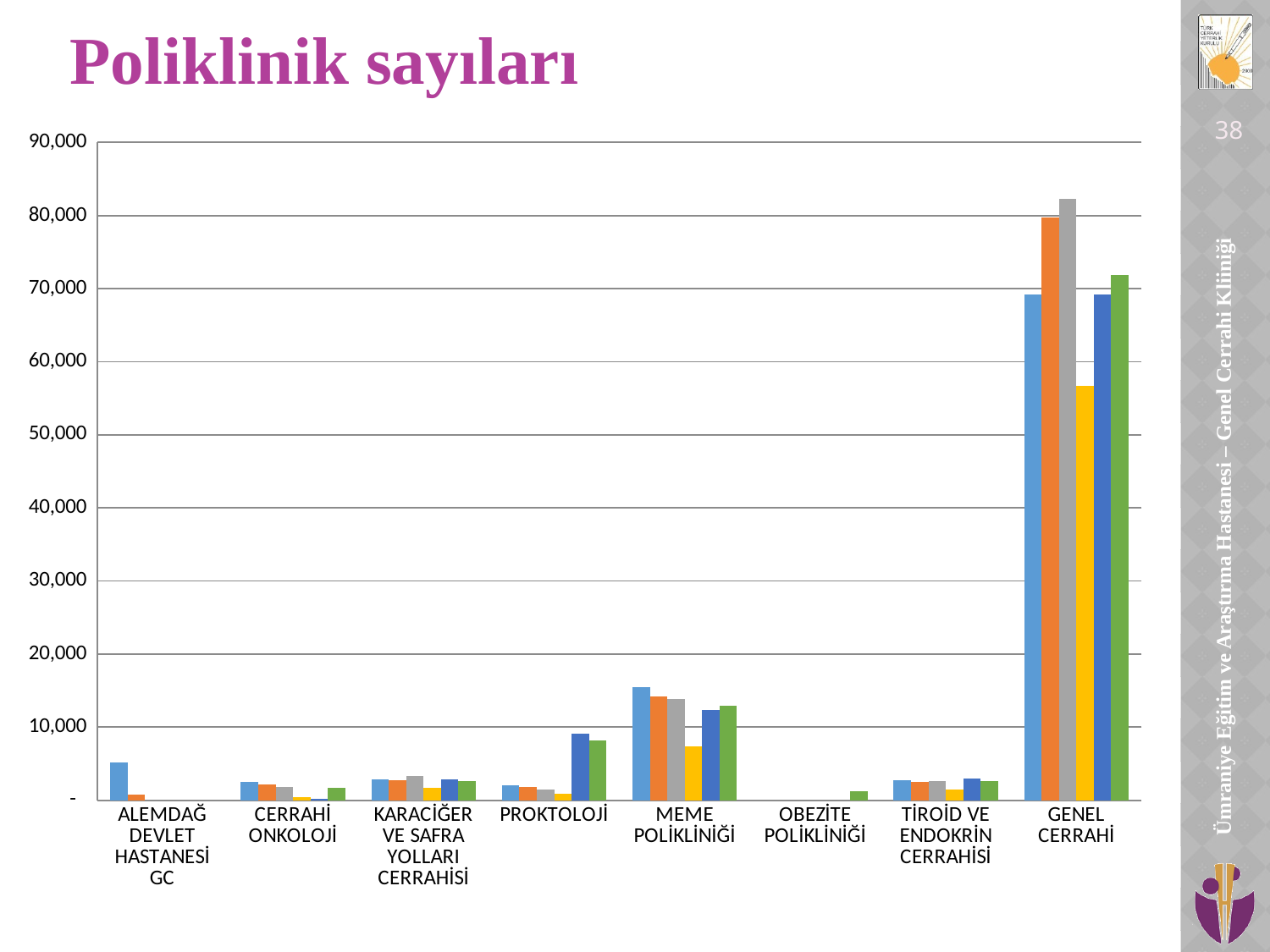
Which category has taller bars, MEME POLİKLİNİĞİ or PROKTOLOJİ? MEME POLİKLİNİĞİ How many categories are shown along the x axis of the chart? 8 What kind of chart is shown on the slide? bar chart Which category has taller bars, GENEL CERRAHİ or MEME POLİKLİNİĞİ? GENEL CERRAHİ Is the tallest bar for GENEL CERRAHİ greater or less than 70,000? greater Which category has the tallest bars in the chart? GENEL CERRAHİ Is the tallest bar for MEME POLİKLİNİĞİ greater or less than 10,000? greater What is the title of the chart on the slide? Poliklinik sayıları What is the highest value shown on the y axis of the chart? 90,000 Is the tallest bar for MEME POLİKLİNİĞİ greater or less than 20,000? less Which category has the smallest bars in the chart? OBEZİTE POLİKLİNİĞİ